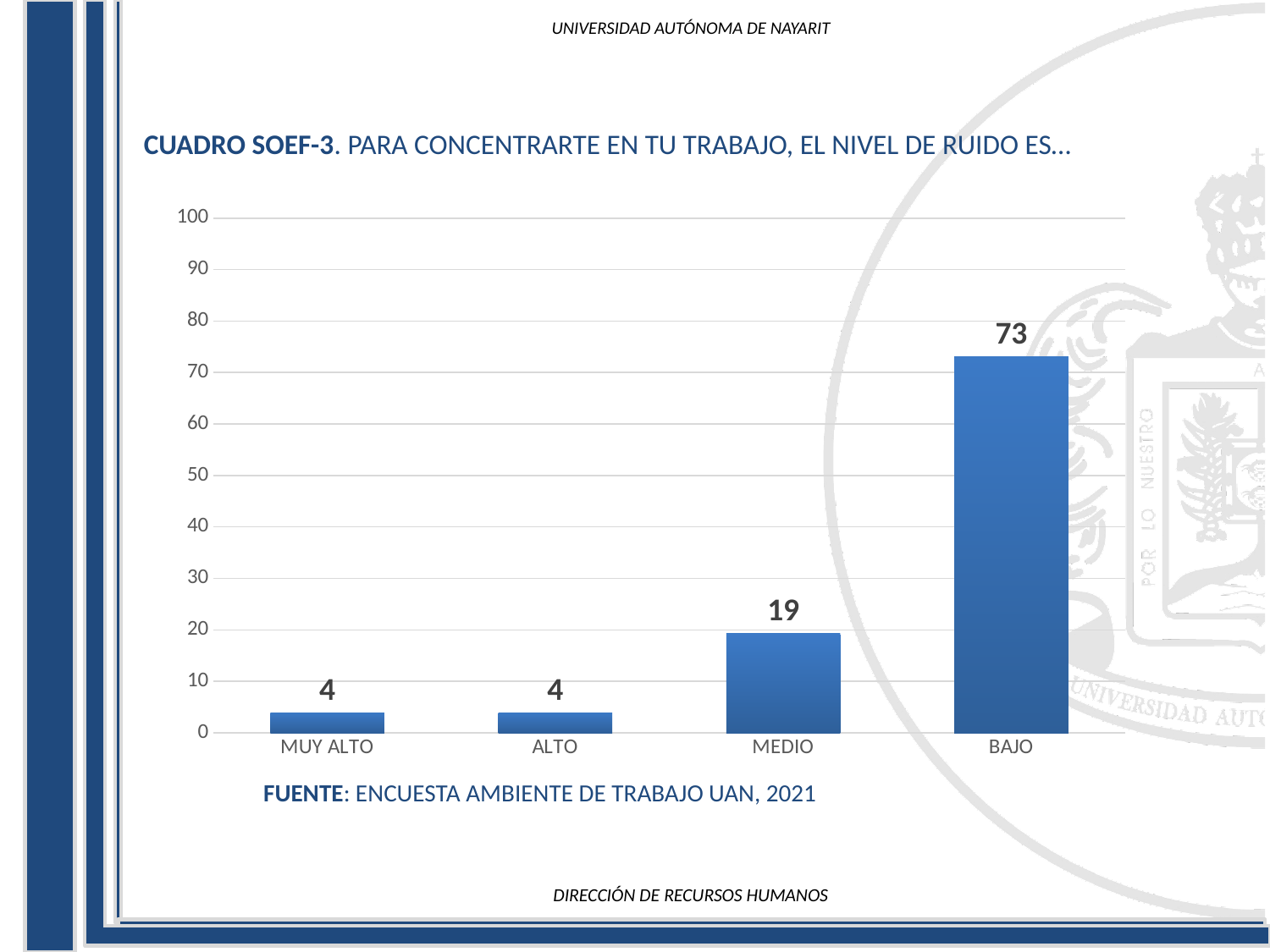
Do the values rise or fall from MUY ALTO to BAJO along the x axis? rise What is the value for MEDIO? 19 What source is cited below the chart? ENCUESTA AMBIENTE DE TRABAJO UAN, 2021 What is the value for MUY ALTO? 4 How many categories are shown on the x axis? 4 What is the total of the values for MUY ALTO and ALTO? 8 What kind of chart is shown on the slide? bar chart What is the difference between the values for BAJO and MEDIO? 54 Which is larger, the value for MEDIO or the value for ALTO? MEDIO Is the value for BAJO greater or less than 70? greater Which category has the highest value? BAJO What is the value for BAJO? 73